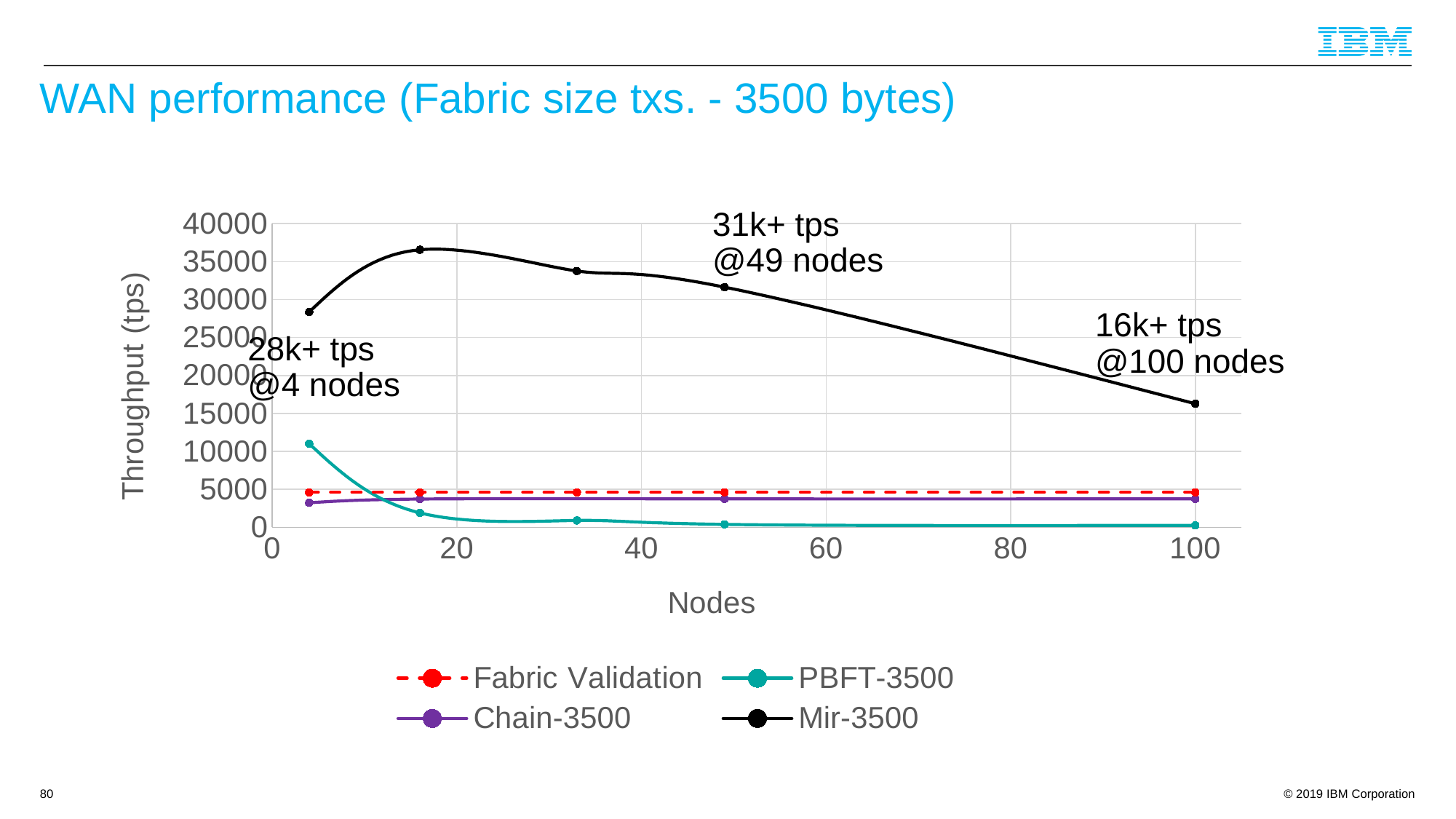
Which series has the highest throughput at 100 nodes? Mir-3500 Does the throughput of PBFT-3500 rise or fall as the number of nodes increases? fall What kind of chart is shown on the slide? line chart How many data points are plotted for the Mir-3500 series? 5 What is the title of the y axis? Throughput (tps) Is the throughput of PBFT-3500 at 4 nodes greater or less than 10000? greater At 4 nodes, which has the higher throughput: Fabric Validation or Chain-3500? Fabric Validation Which series has the lowest throughput at 100 nodes? PBFT-3500 Does the throughput of Mir-3500 rise or fall as the number of nodes increases from 16 to 100? fall Is the throughput of Mir-3500 at 16 nodes greater or less than 35000? greater Is the throughput of Mir-3500 at 100 nodes greater or less than 20000? less How many series does the legend list? 4